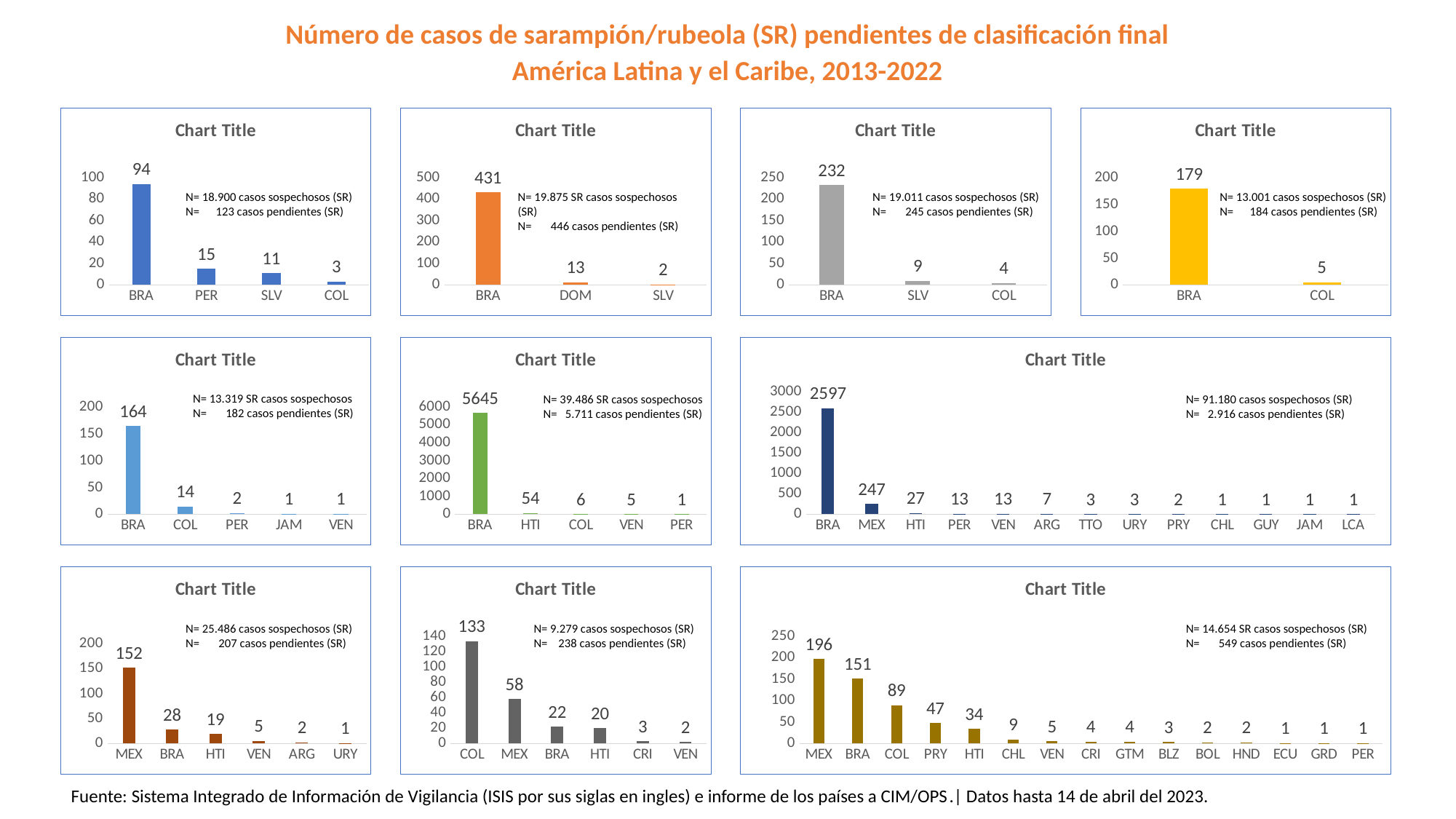
In the wide chart on the right of the middle row, which category has the lowest value among BRA, MEX and HTI? HTI In the wide chart on the right of the bottom row, do the values rise or fall from left to right along the x axis? Fall In the second chart of the top row, what is the value for DOM? 13 In the bottom-left chart, is the value for MEX greater or less than 100? greater In the middle chart of the middle row, what is the value for HTI? 54 What kind of chart is the bottom-left chart? Bar chart In the middle chart of the bottom row, which is larger, the value for MEX or the value for BRA? MEX In the top-left chart, what is the value for BRA? 94 In the third chart of the top row, which category has the highest value? BRA In the top-right chart, what is the difference between the values for BRA and COL? 174 In the wide chart on the right of the bottom row, what is the value for PRY? 47 In the left chart of the middle row, how many categories are shown on the x axis? 5